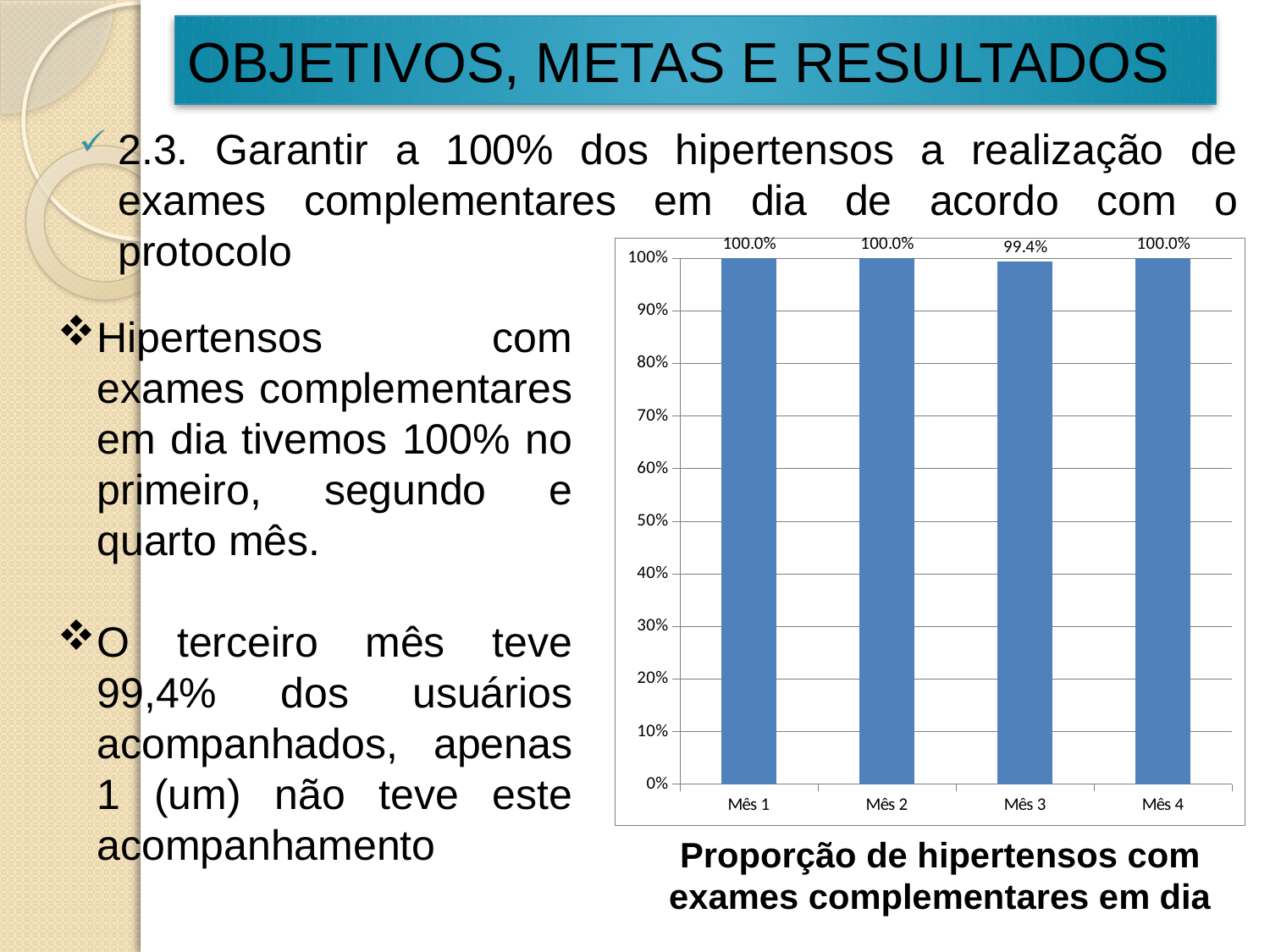
What is the caption below the chart? Proporção de hipertensos com exames complementares em dia What is the value for Mês 4? 100.0% What kind of chart is shown on the slide? bar chart What is the value for Mês 1? 100.0% How many months are shown on the x axis? 4 What is the value for Mês 3? 99.4% What colour are the bars in the chart? blue Is the value for Mês 3 greater or less than 90%? greater What is the highest tick value shown on the y axis? 100% Which is larger, the value for Mês 1 or the value for Mês 3? Mês 1 What is the difference between the values for Mês 2 and Mês 3? 0.6% Which month has the lowest value? Mês 3